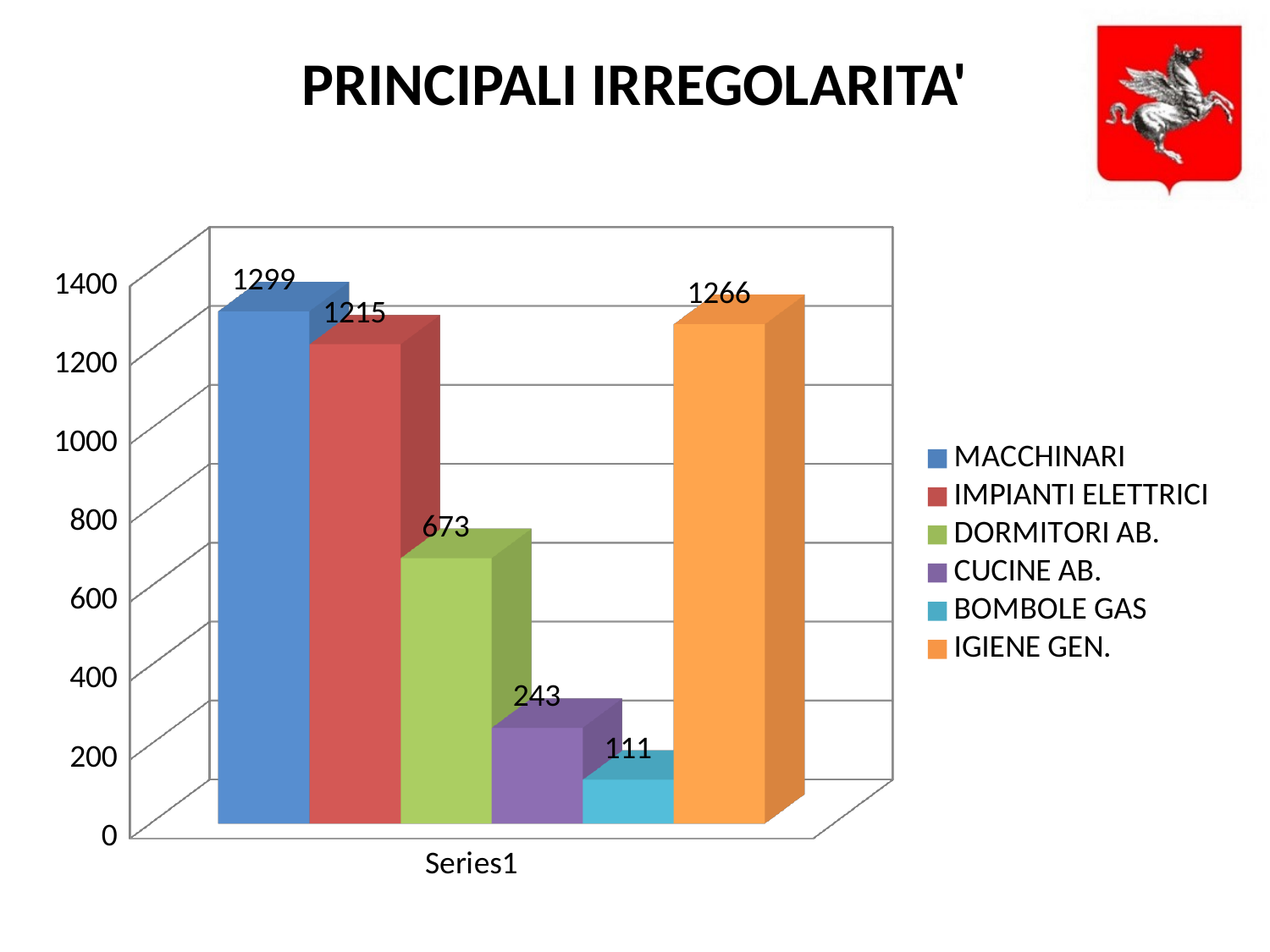
Which category has the lowest value? BOMBOLE GAS What is the value for DORMITORI AB.? 673 What is the title of the slide? PRINCIPALI IRREGOLARITA' What kind of chart is shown on the slide? bar chart What is the value for MACCHINARI? 1299 Which is larger, the value for IGIENE GEN. or the value for DORMITORI AB.? IGIENE GEN. What is the value for IMPIANTI ELETTRICI? 1215 What is the difference between the values for MACCHINARI and IMPIANTI ELETTRICI? 84 What is the value for BOMBOLE GAS? 111 What is the difference between the values for CUCINE AB. and BOMBOLE GAS? 132 How many series does the legend list? 6 Which category has the highest value? MACCHINARI